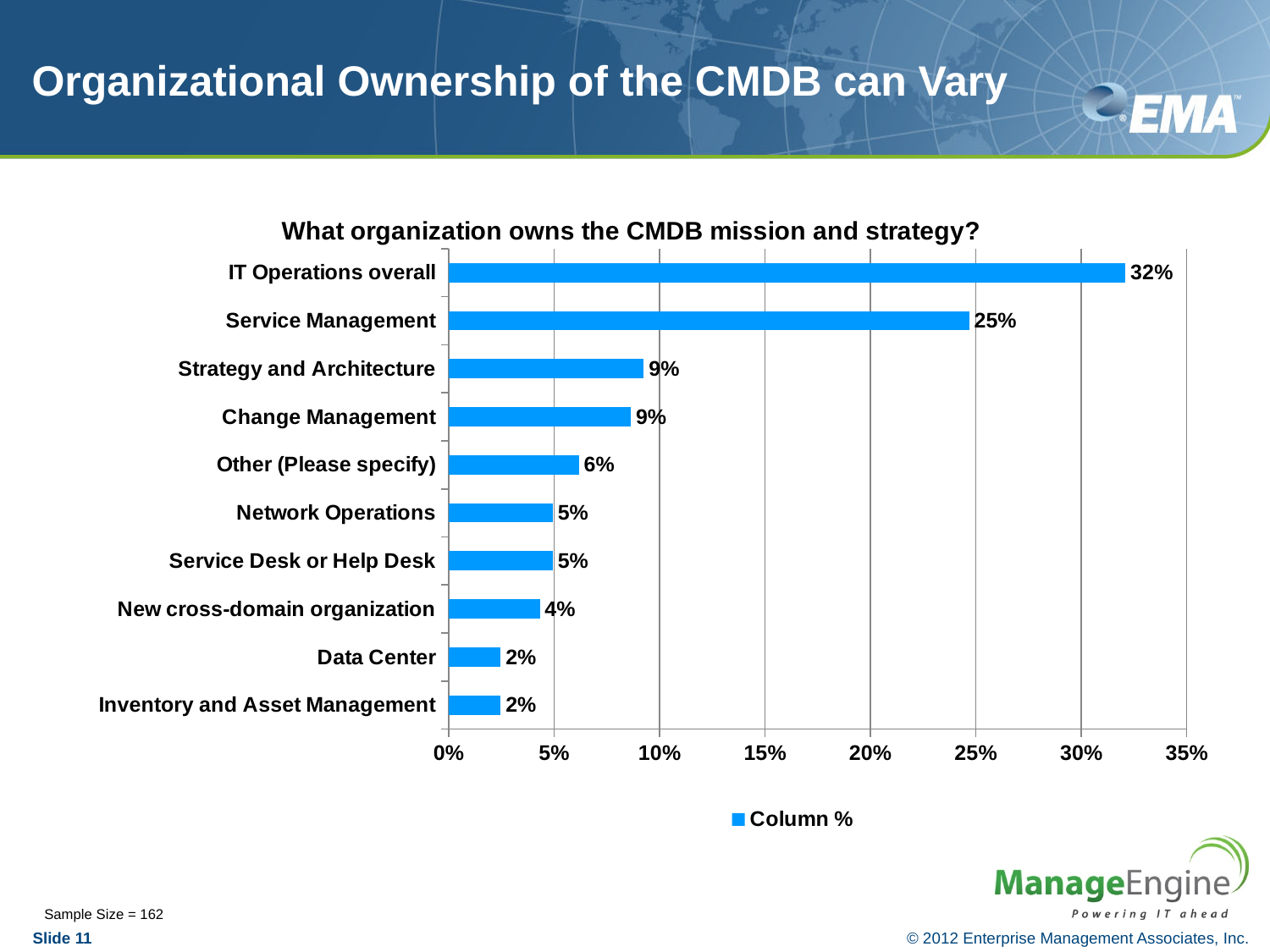
What is the value for Service Management? 25% Which is larger, the value for Service Management or the value for Strategy and Architecture? Service Management What kind of chart is shown on the slide? bar chart What is the title of the chart? What organization owns the CMDB mission and strategy? Which category has the highest value? IT Operations overall What is the value for IT Operations overall? 32% How many categories are shown in the chart? 10 What is the difference between the values for IT Operations overall and Service Management? 7% What is the value for New cross-domain organization? 4% Is the value for Service Management greater or less than 20%? greater How many series does the legend list? 1 What is the value for Other (Please specify)? 6%